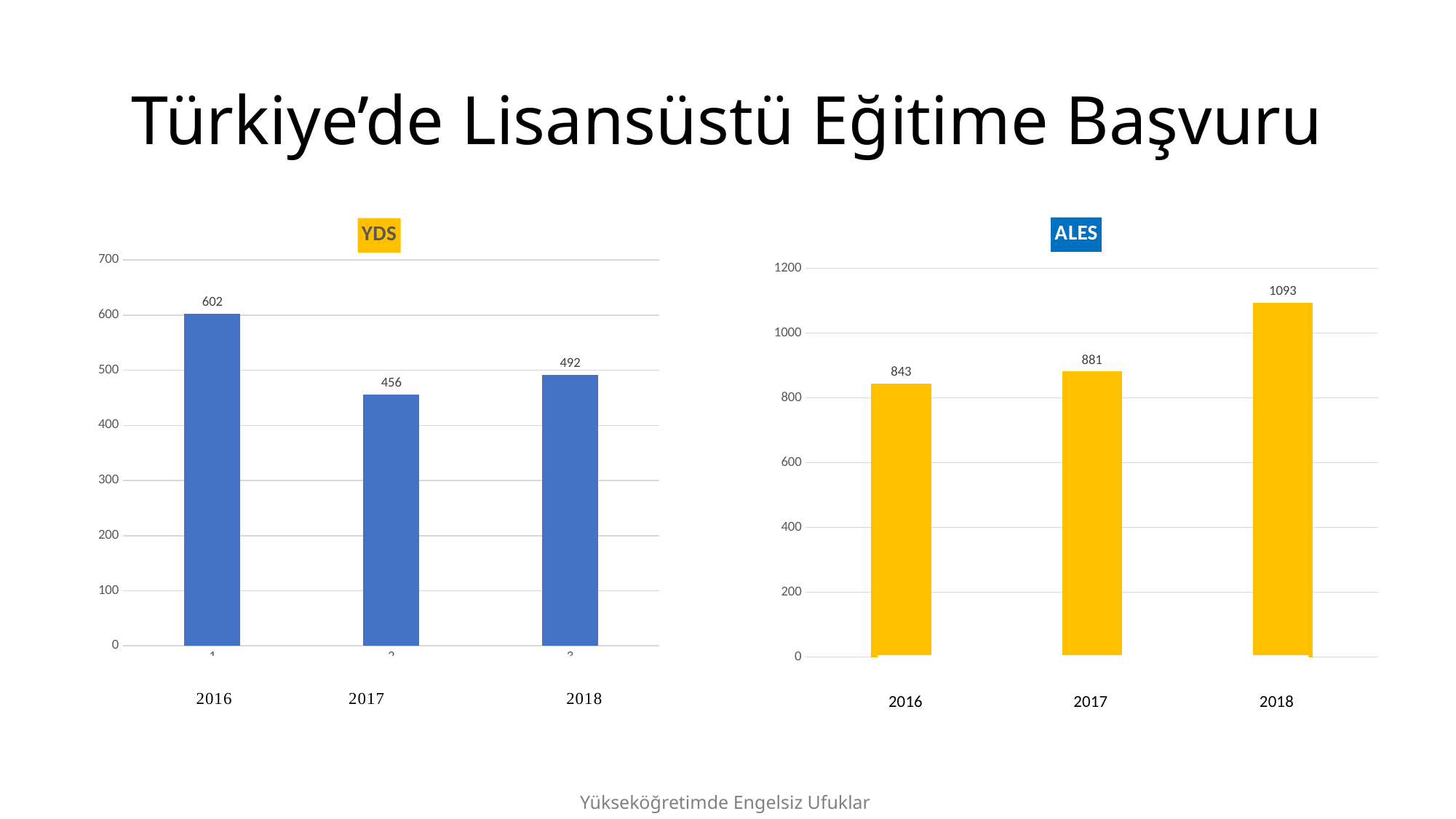
How many years are shown in the YDS chart? 3 In the ALES chart, what is the value for 2016? 843 In the ALES chart, do the values rise or fall from 2016 to 2018? rise In the YDS chart, which year has the lowest value? 2017 In the YDS chart, what is the value for 2017? 456 In the YDS chart, what is the value for 2016? 602 In the ALES chart, what is the value for 2018? 1093 In the YDS chart, which year has the highest value? 2016 What kind of chart is the ALES chart? bar chart In the ALES chart, which year has the highest value? 2018 In the YDS chart, what is the difference between the 2016 and 2018 values? 110 In the ALES chart, what is the difference between the 2018 and 2017 values? 212